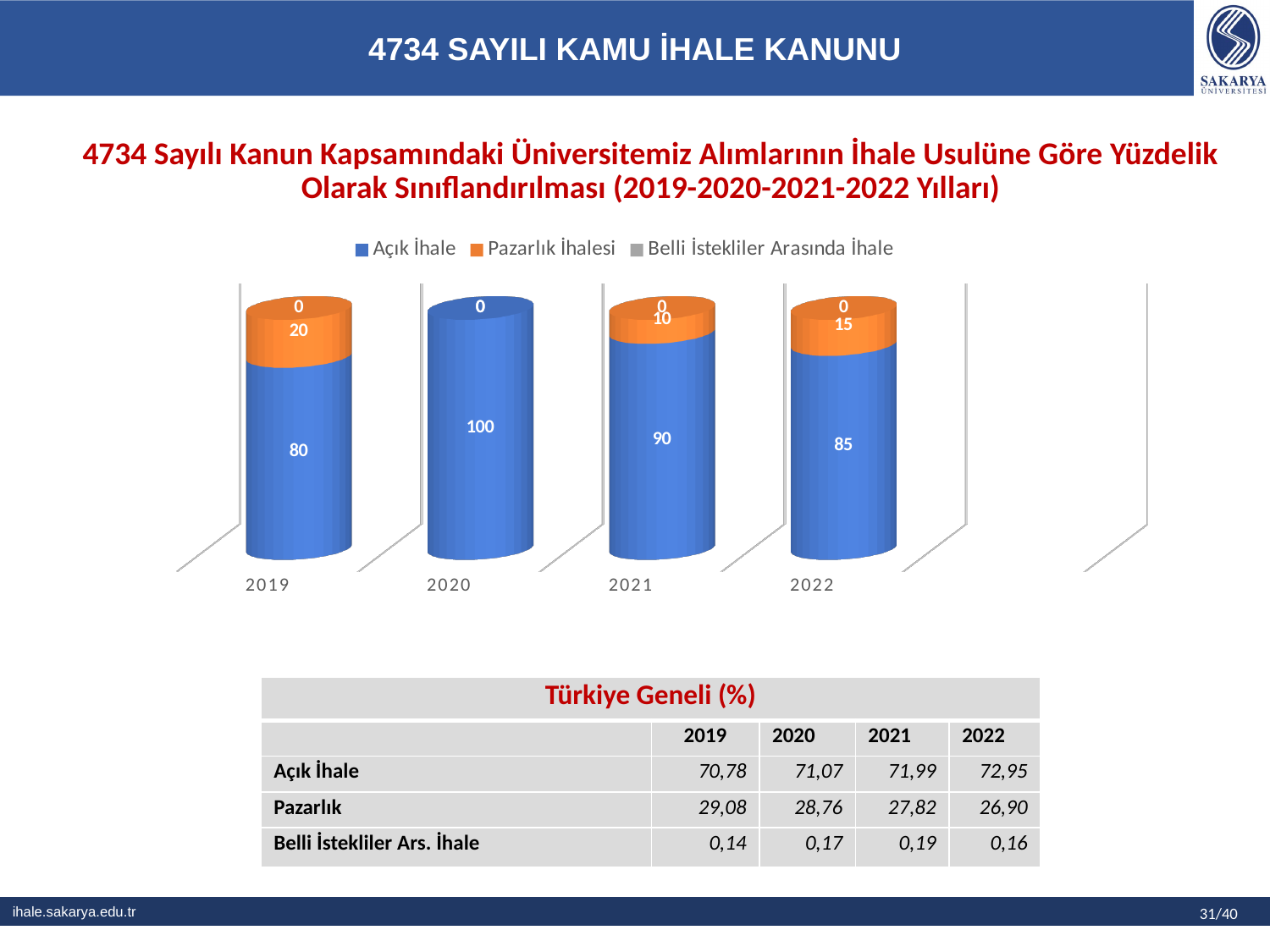
In which year is Açık İhale lowest? 2019 What kind of chart is shown on the slide? Stacked bar chart What is the difference between the Açık İhale values for 2021 and 2019? 10 How many series does the chart legend list? 3 In which year is Açık İhale highest? 2020 What is the value of Açık İhale for 2019? 80 What is the value of Pazarlık İhalesi for 2022? 15 What is the value of Pazarlık İhalesi for 2021? 10 How many years are shown on the x axis of the chart? 4 Which is larger, Pazarlık İhalesi in 2019 or in 2022? 2019 Which series is shown in orange in the chart? Pazarlık İhalesi What is the value of Açık İhale for 2020? 100